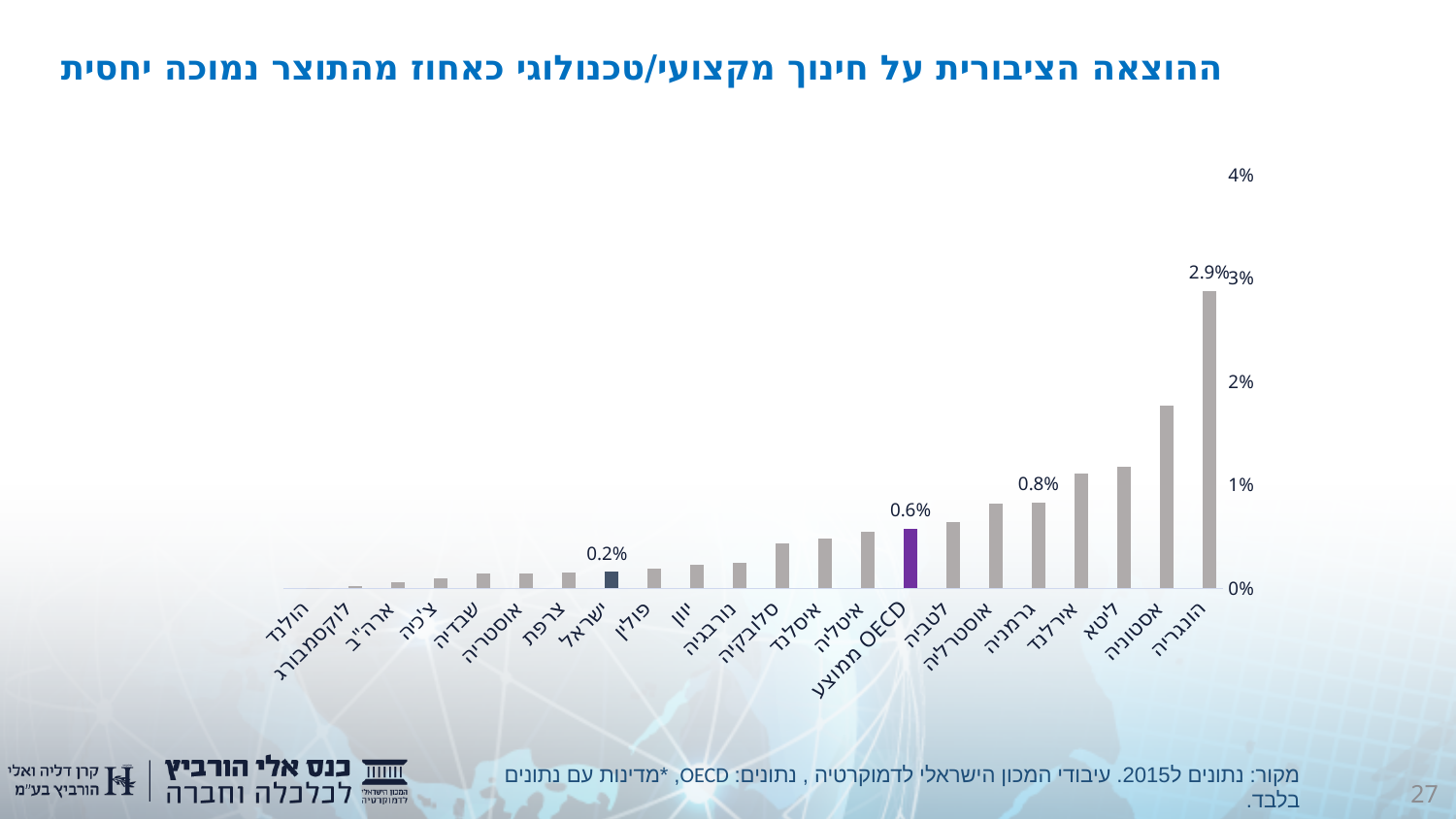
What is the value shown for הונגריה (Hungary)? 2.9% Which country has the highest value in the chart? הונגריה (Hungary) What is the value shown for גרמניה (Germany)? 0.8% What is the value shown for ישראל (Israel)? 0.2% What colour is the bar for ממוצע OECD (OECD average)? Purple Which is larger, the value for ישראל (Israel) or the value for ממוצע OECD (OECD average)? ממוצע OECD (OECD average) Do the values generally rise or fall from left to right along the x axis? Rise What is the value shown for ממוצע OECD (OECD average)? 0.6% What kind of chart is shown on the slide? Bar chart Is the value for אסטוניה (Estonia) greater or less than 1%? greater What is the difference between the OECD average and Israel's value? 0.4%